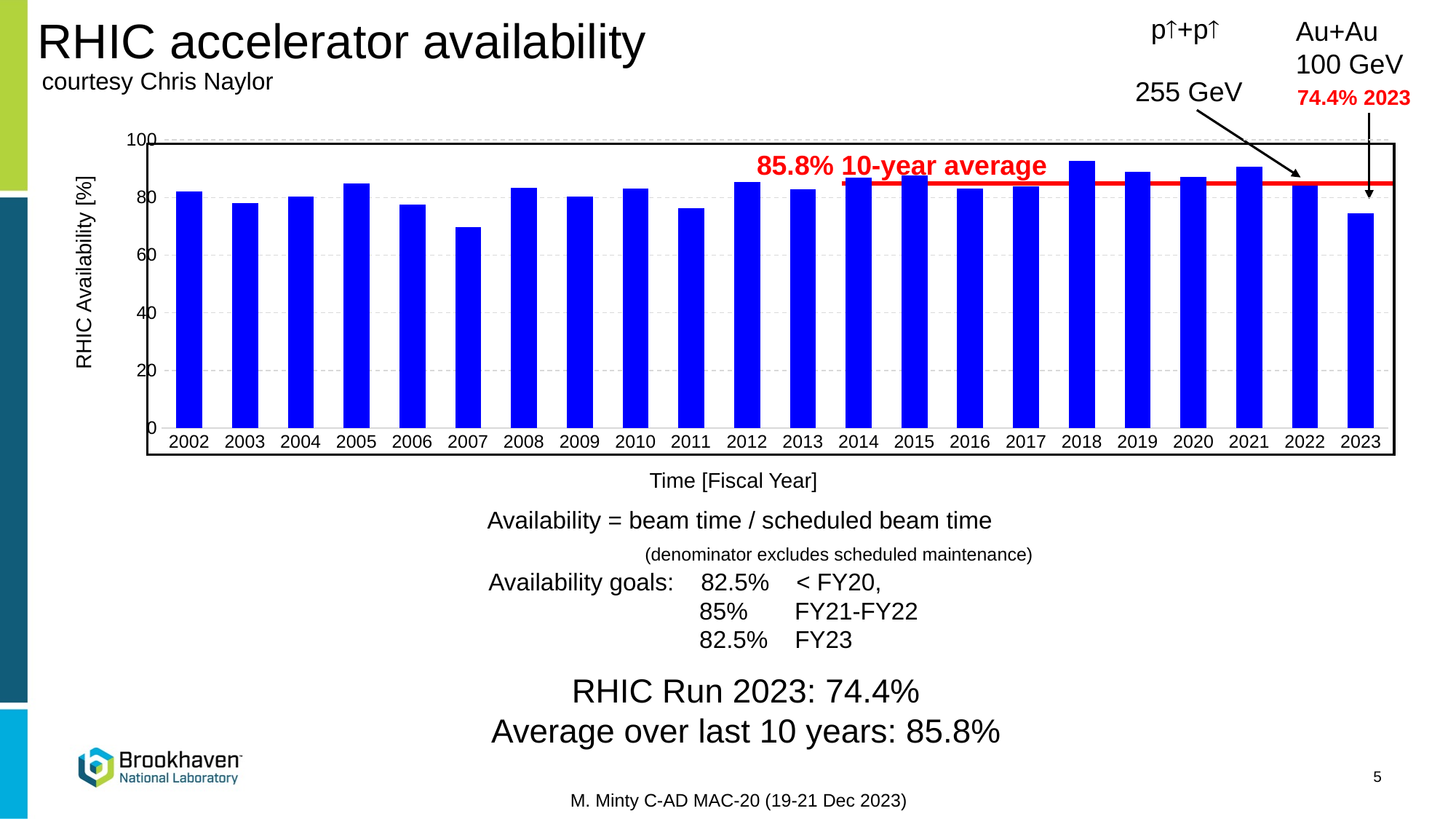
Is the RHIC availability for 2011 greater or less than 80? less How many fiscal years are plotted on the chart? 22 What is the RHIC availability value labelled for 2023? 74.4% Is the RHIC availability for 2018 greater or less than 80? greater Which year has the higher RHIC availability, 2018 or 2023? 2018 Which fiscal year has the lowest RHIC availability? 2007 Which fiscal year has the highest RHIC availability? 2018 What kind of chart is shown on the slide? bar chart Is the RHIC availability for 2007 greater or less than 80? less What is the label of the vertical axis of the chart? RHIC Availability [%] What value does the red horizontal line on the chart represent? 85.8% 10-year average Which year has the higher RHIC availability, 2012 or 2011? 2012